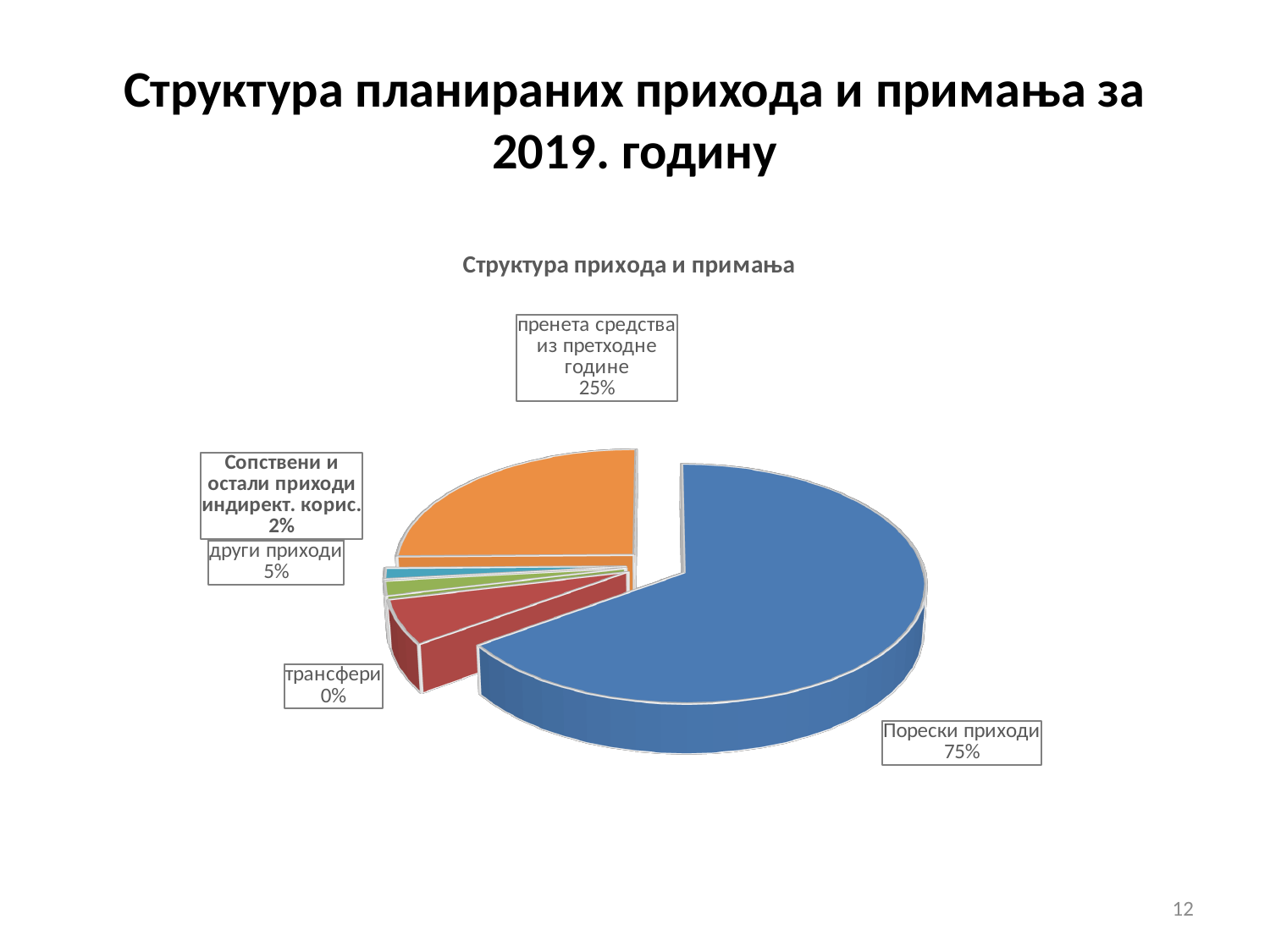
What share of the pie is Порески приходи? 75% What share of the pie is други приходи? 5% What share of the pie is трансфери? 0% What is the chart's title? Структура прихода и примања Which is larger, the share for други приходи or the share for Сопствени и остали приходи индирект. корис.? други приходи Which category has the smallest share of the pie? трансфери What share of the pie is пренета средства из претходне године? 25% What share of the pie is Сопствени и остали приходи индирект. корис.? 2% What kind of chart is shown on the slide? pie chart How many categories (slices) does the pie chart show? 5 What is the difference in percentage points between Порески приходи and пренета средства из претходне године? 50 percentage points Which category has the largest share of the pie? Порески приходи